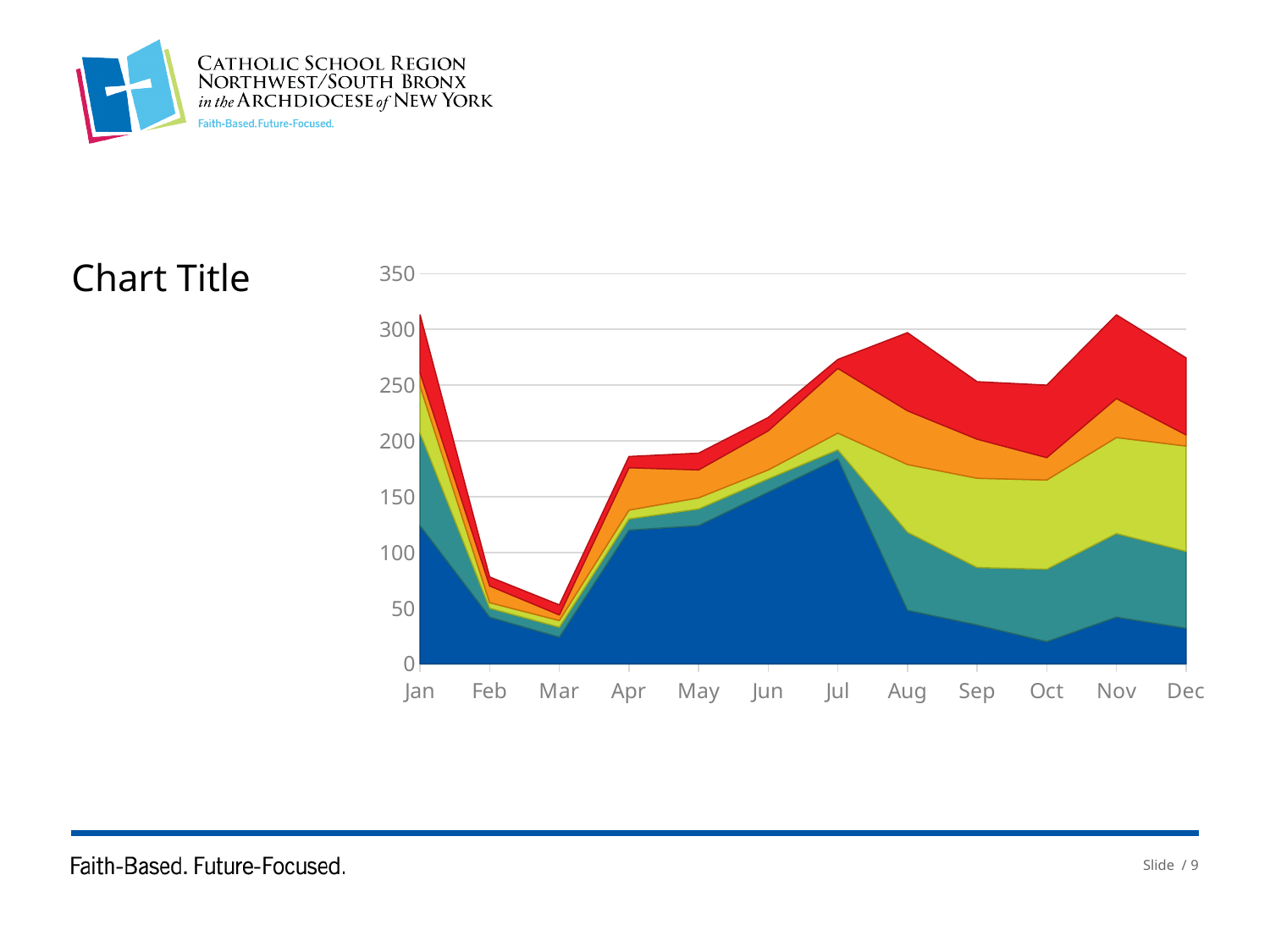
Which month has the larger stacked total, Jul or Feb? Jul Is the stacked total for Mar greater or less than 100? less How many coloured bands are stacked in the chart? 5 Is the value of the bottom (blue) band for Jul greater or less than 150? greater Does the stacked total rise or fall from Mar to Jul? rise Is the stacked total for Jul greater or less than 250? greater How many months are shown along the x axis of the chart? 12 What is the title of the chart? Chart Title What kind of chart is shown on the slide? Stacked area chart Which month has the lowest stacked total in the chart? Mar